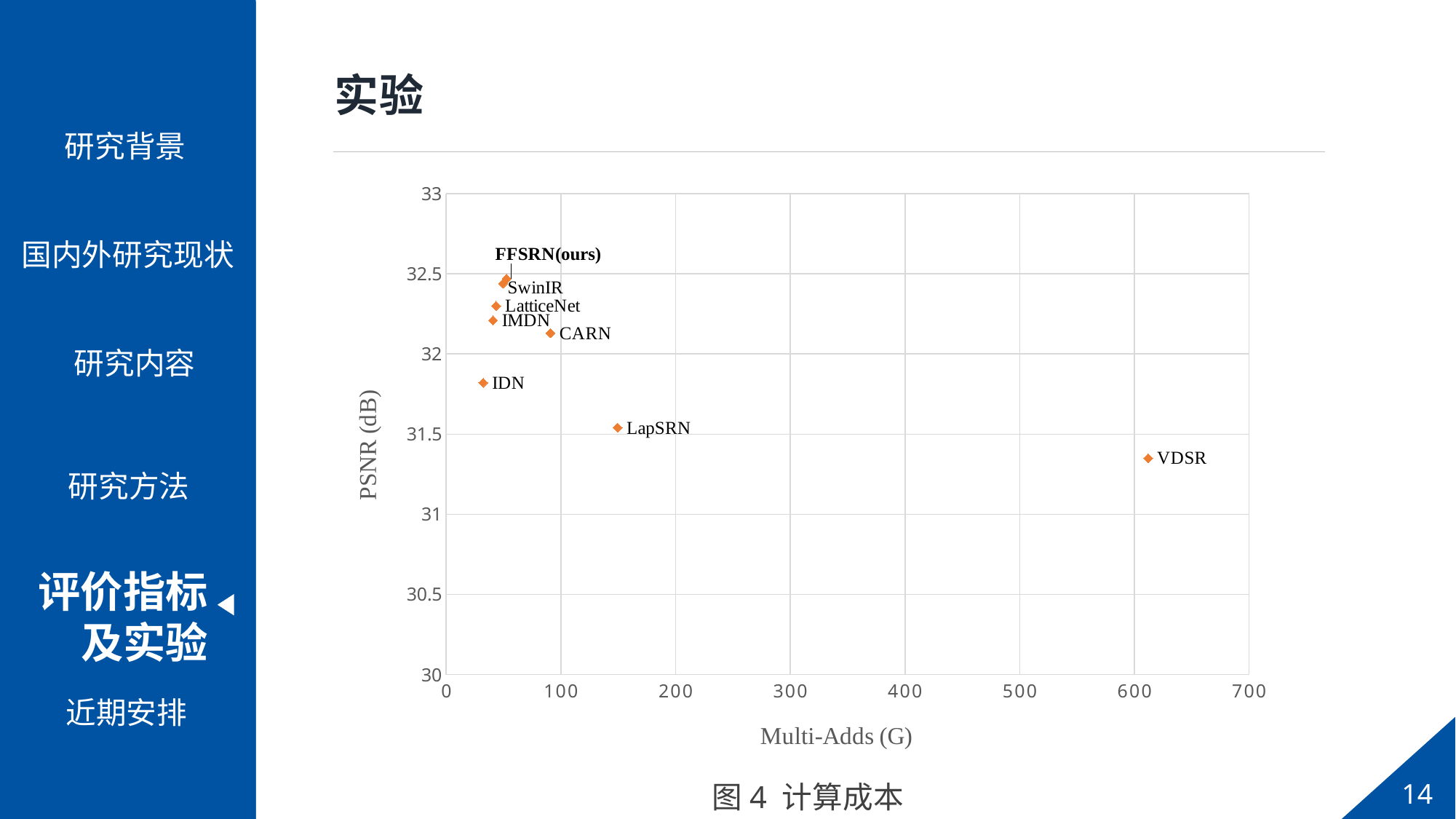
What is the label of the x axis of the chart? Multi-Adds (G) Is the Multi-Adds (G) value for VDSR greater or less than 600? greater Which has a higher PSNR (dB), LapSRN or VDSR? LapSRN Is the PSNR (dB) value for IDN greater or less than 32? less Which method has the highest Multi-Adds (G) value in the chart? VDSR Is the PSNR (dB) value for CARN greater or less than 32? greater What is the caption shown below the chart? 图 4 计算成本 How many labeled data points are plotted in the chart? 8 What kind of chart is shown on the slide? scatter chart Which method has the lowest PSNR (dB) in the chart? VDSR